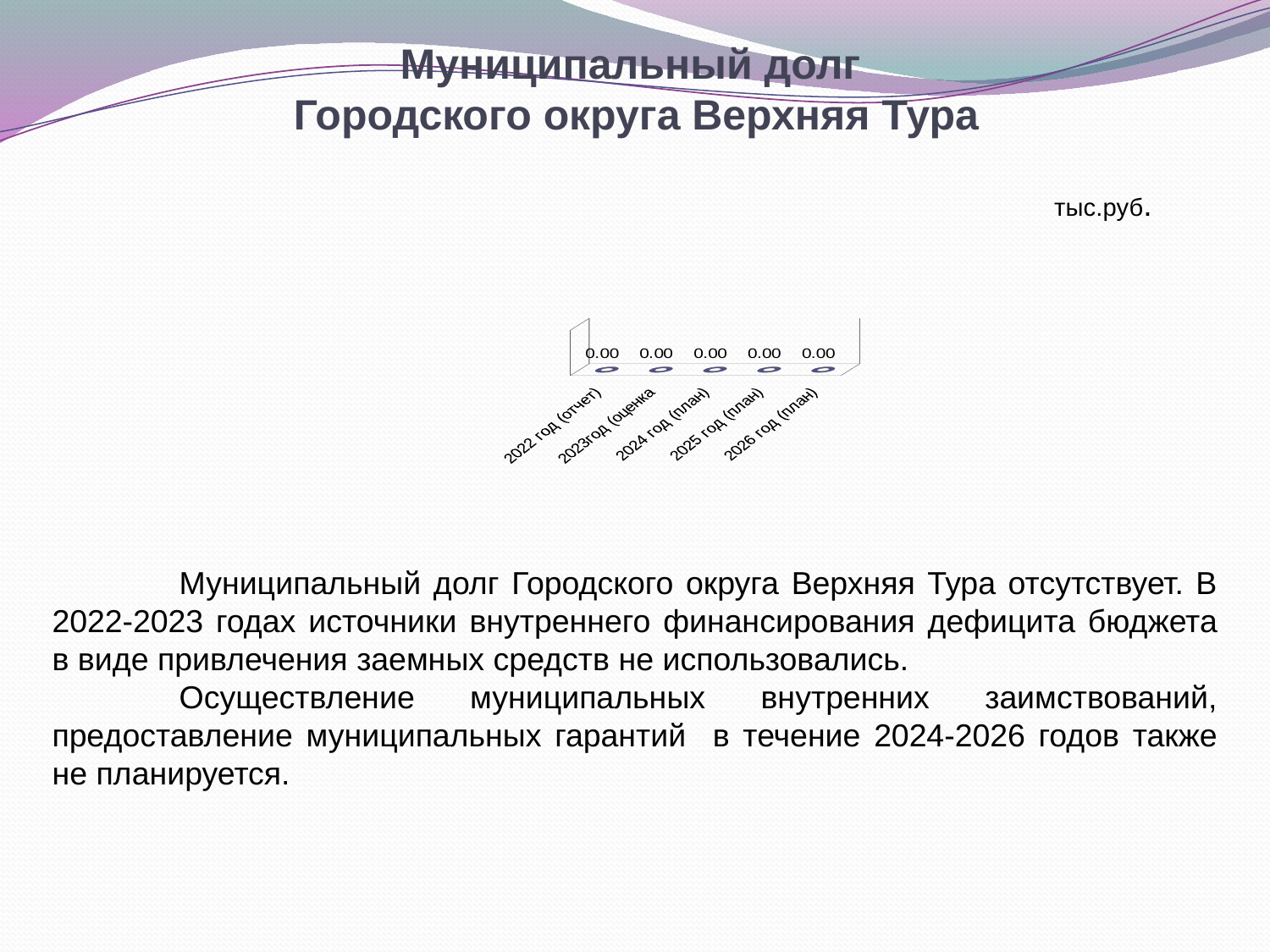
What unit of measurement is indicated for the chart? тыс.руб. Do the values rise, fall or stay flat from 2022 to 2026? stay flat What is the value shown for 2025 год (план)? 0.00 What kind of chart is shown on the slide? bar chart What is the value shown for 2024 год (план)? 0.00 What is the value shown for 2022 год (отчет)? 0.00 How many categories are plotted on the chart? 5 Which year is labelled as the report (отчет) year on the x axis? 2022 год What is the value shown for 2026 год (план)? 0.00 What is the difference between the values for 2022 год (отчет) and 2026 год (план)? 0.00